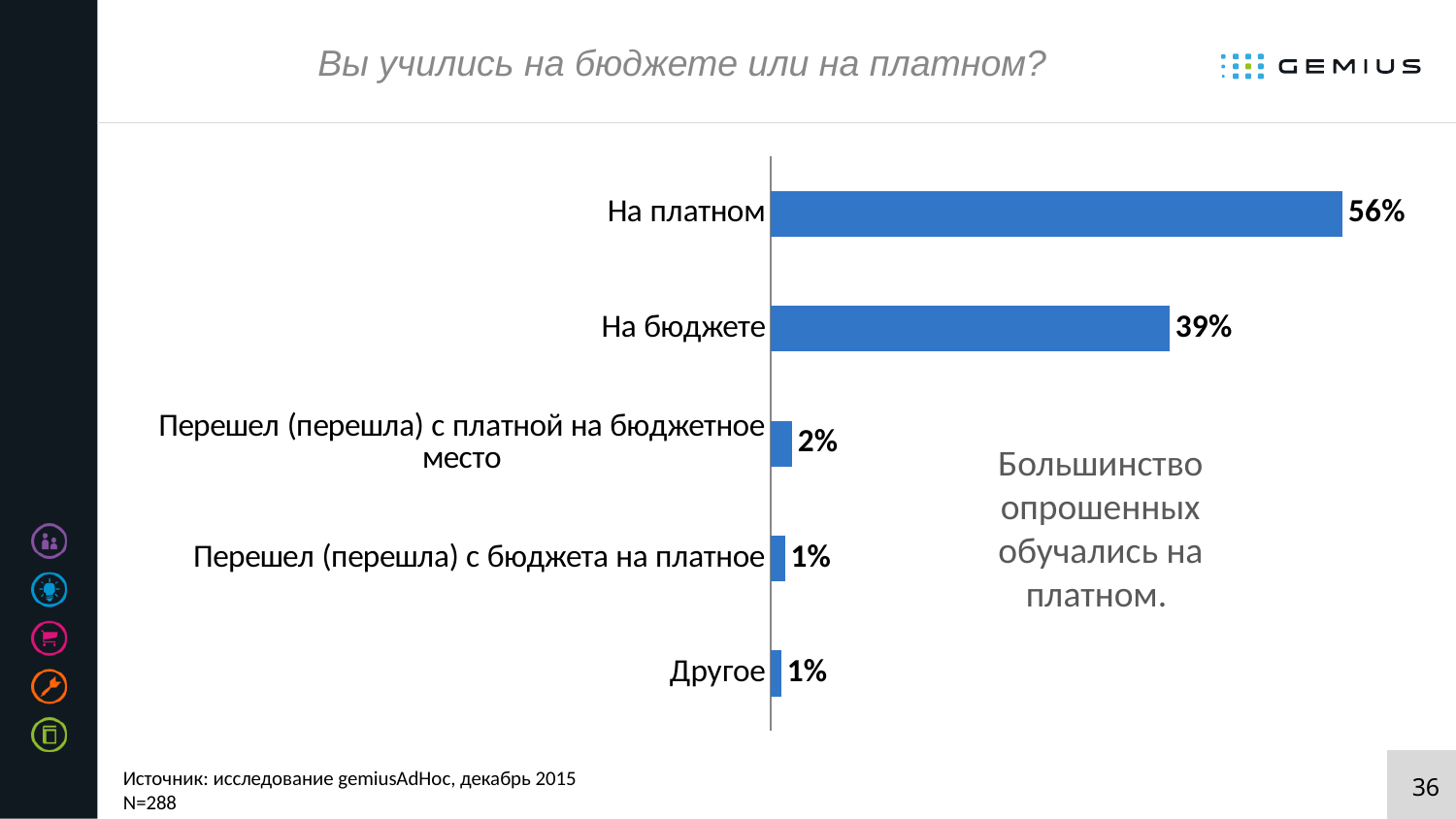
What is the value for "На бюджете"? 39% What is the sample size (N) stated on the slide? N=288 What kind of chart is shown on the slide? Bar chart What is the value for "Другое"? 1% What is the difference between the values for "На платном" and "На бюджете"? 17% How many categories are shown in the chart? 5 Which category has the highest value? На платном Which is larger: the value for "На бюджете" or the value for "Перешел (перешла) с платной на бюджетное место"? На бюджете What is the title of the slide containing the chart? Вы учились на бюджете или на платном? What is the value for "Перешел (перешла) с платной на бюджетное место"? 2% What is the value for "На платном"? 56% What is the value for "Перешел (перешла) с бюджета на платное"? 1%